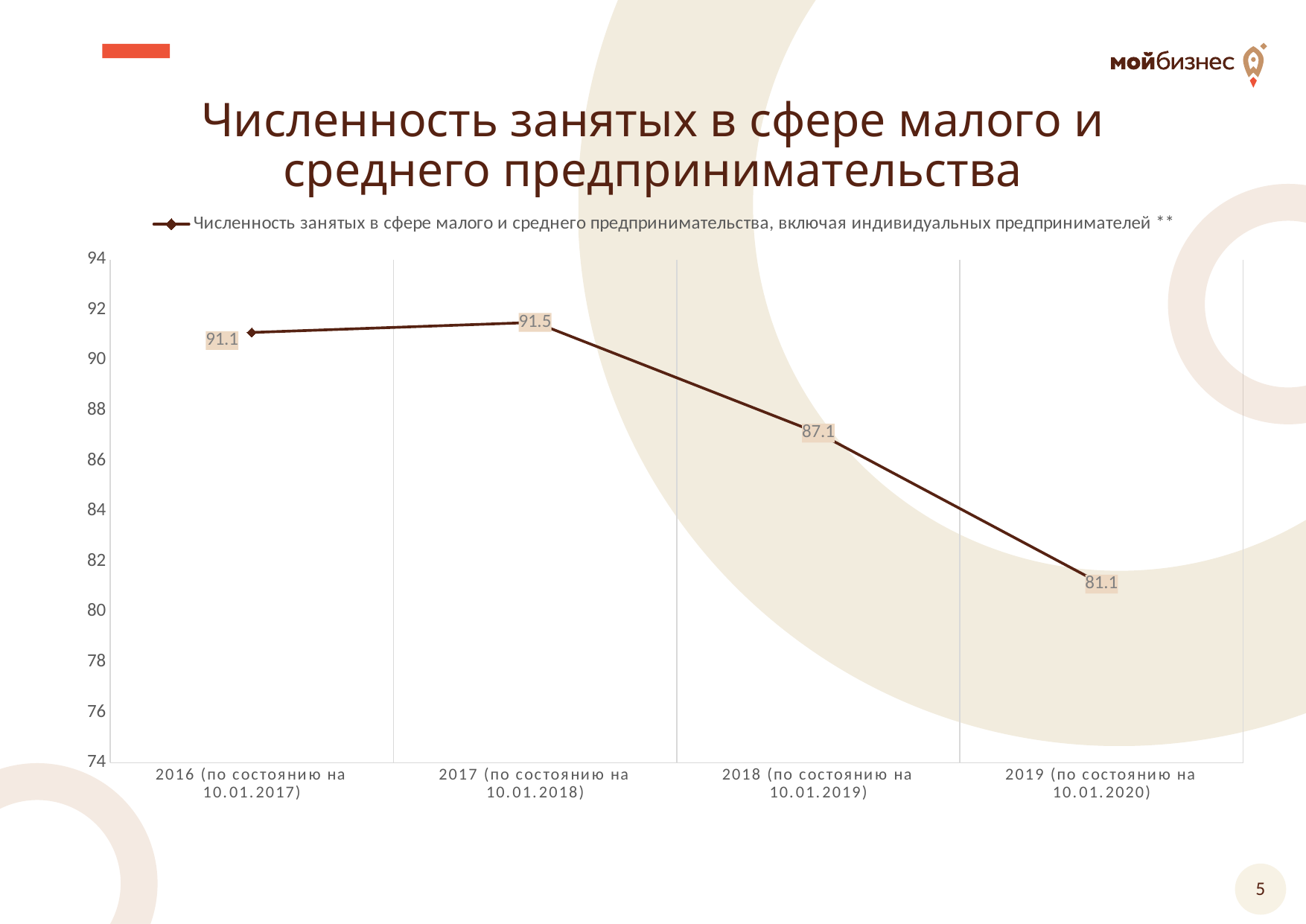
What is the value for 2016 (по состоянию на 10.01.2017)? 91.1 Which is larger, the value for 2016 or the value for 2018? 2016 What is the difference between the values for 2017 and 2019? 10.4 What kind of chart is shown on the slide? Line chart Which year has the highest value? 2017 (по состоянию на 10.01.2018) What is the value for 2019 (по состоянию на 10.01.2020)? 81.1 What is the difference between the values for 2018 and 2019? 6 What is the value for 2017 (по состоянию на 10.01.2018)? 91.5 Which year has the lowest value? 2019 (по состоянию на 10.01.2020) What is the value for 2018 (по состоянию на 10.01.2019)? 87.1 How many data points are plotted on the chart? 4 Do the values rise or fall from 2017 to 2019? Fall